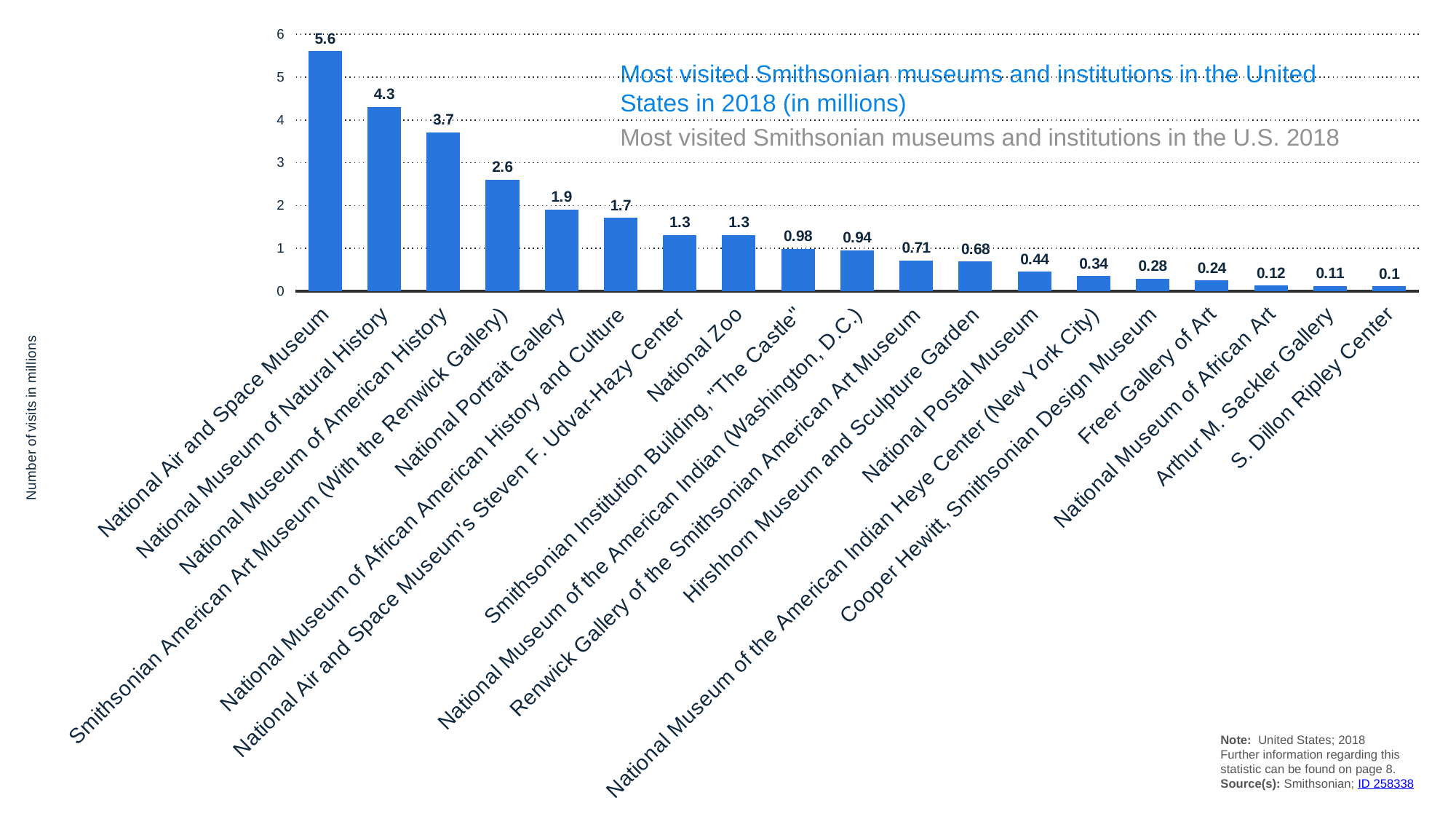
What is the difference in visits between the National Museum of Natural History and the National Museum of American History? 0.6 What is the value for the National Air and Space Museum? 5.6 What is the label of the vertical axis? Number of visits in millions Which has more visits, the National Portrait Gallery or the National Zoo? National Portrait Gallery Which museum or institution has the highest number of visits? National Air and Space Museum Which museum or institution has the lowest number of visits? S. Dillon Ripley Center How many museums and institutions are shown in the chart? 19 What is the value for the Hirshhorn Museum and Sculpture Garden? 0.68 What is the value for the National Postal Museum? 0.44 Do the values rise or fall from left to right along the x axis? Fall Is the value for the Smithsonian American Art Museum (With the Renwick Gallery) greater or less than 2? greater What kind of chart is shown on the slide? Bar chart